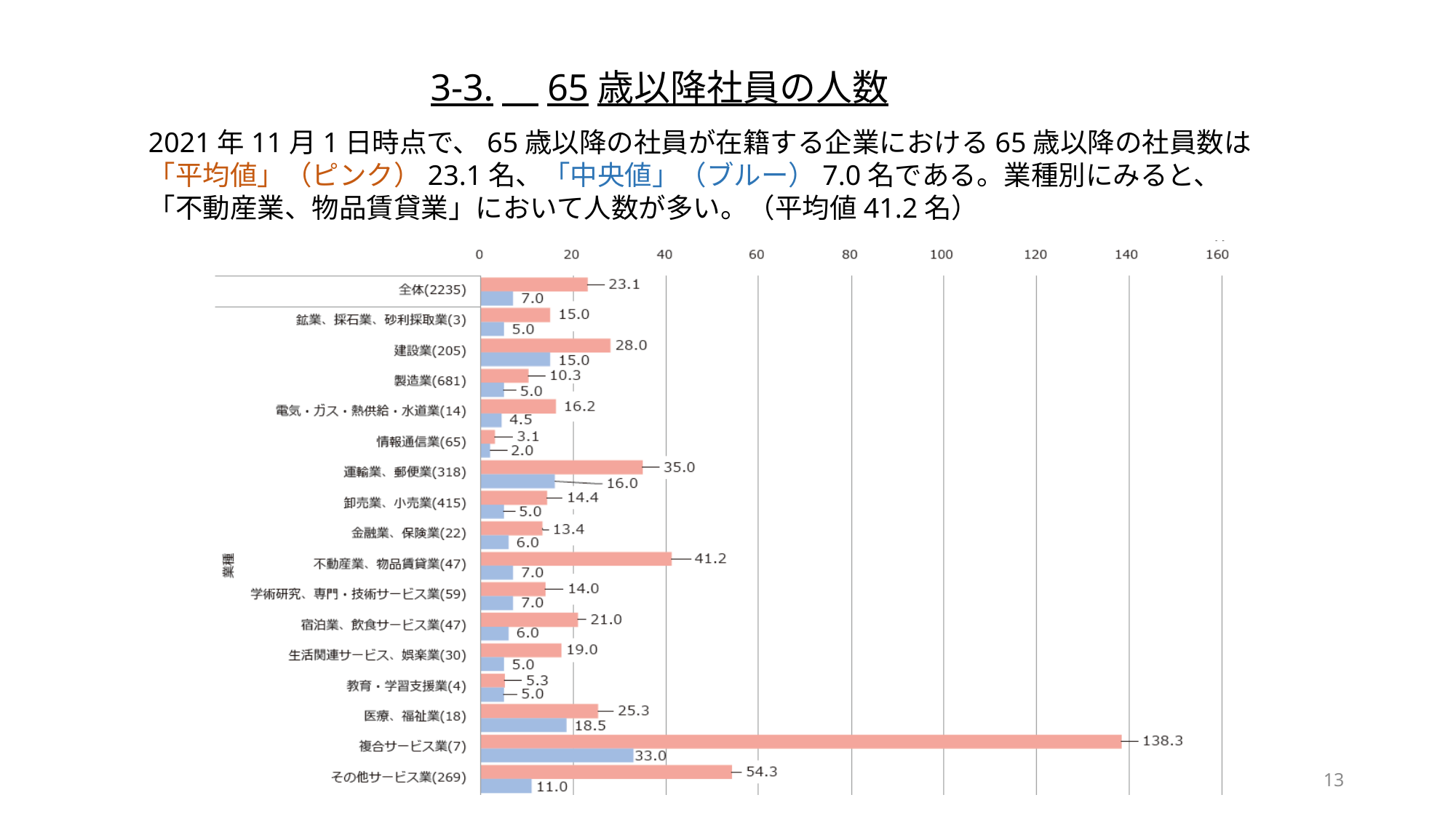
What is the 平均値 (pink bar) for 不動産業、物品賃貸業(47)? 41.2 How many industry categories (including 全体) are plotted on the chart? 17 What is the 中央値 (blue bar) for 複合サービス業(7)? 33.0 What is the 中央値 (blue bar) for 医療、福祉業(18)? 18.5 Which colour represents the 中央値 series in the chart? blue Which industry category has the lowest 平均値 (pink bar)? 情報通信業(65) What is the 平均値 (pink bar) for 全体(2235)? 23.1 Which industry category has the highest 平均値 (pink bar)? 複合サービス業(7) How many data series are plotted for each category? 2 What is the difference between the 平均値 and 中央値 for 複合サービス業(7)? 105.3 What type of chart is shown on the slide? bar chart Which is larger, the 平均値 for 建設業(205) or the 平均値 for 運輸業、郵便業(318)? 運輸業、郵便業(318)